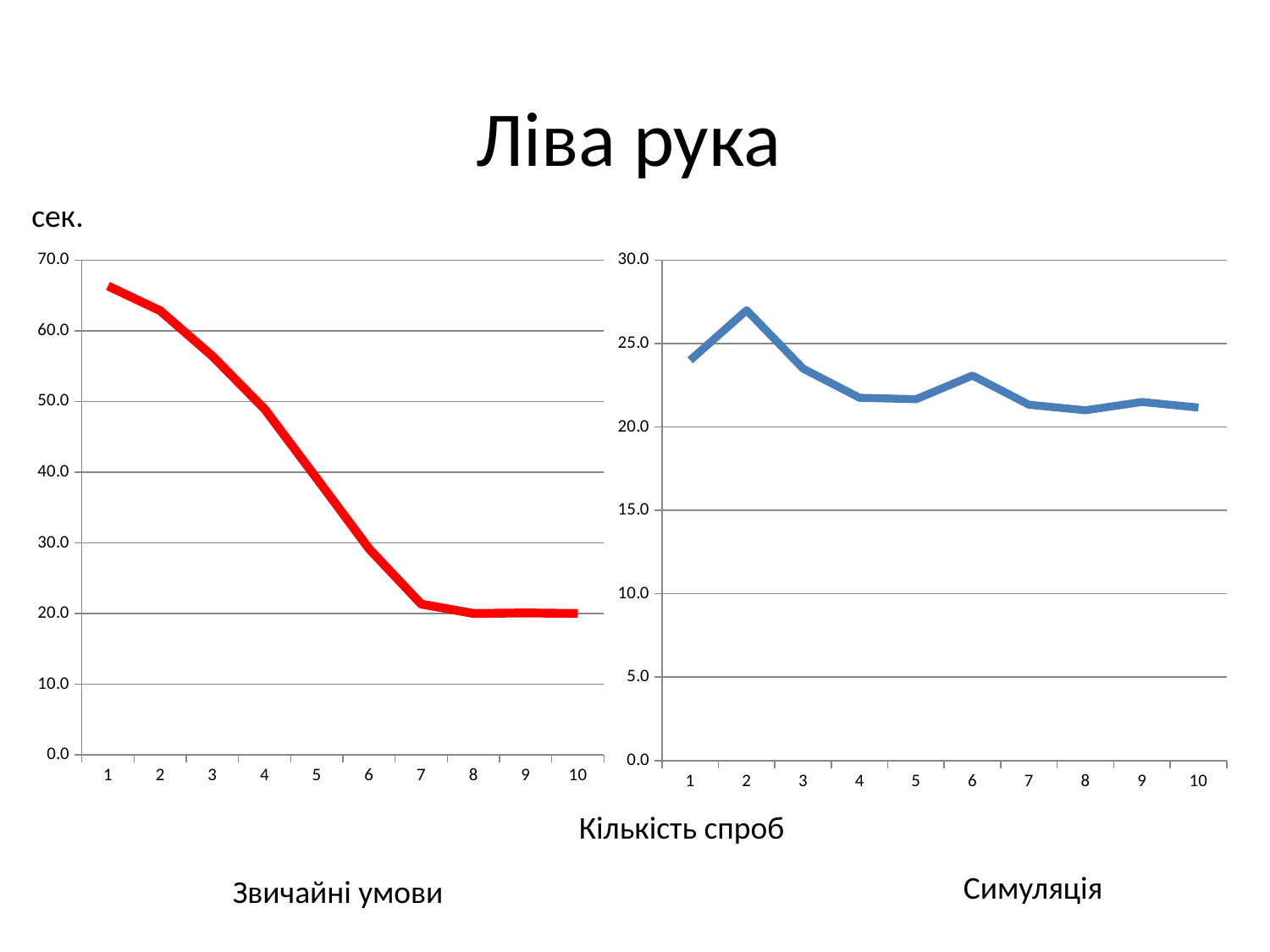
What kind of chart is the left chart (Звичайні умови)? Line chart In the left chart (Звичайні умови), is the value for trial 3 greater or less than 50? greater In the left chart (Звичайні умови), is the value for trial 1 greater or less than 60? greater In the left chart (Звичайні умови), do the values generally rise or fall as the trial number increases? Fall In the right chart (Симуляція), is the value for trial 2 greater or less than 25? greater How many trials (points) are plotted on the x axis of the right chart (Симуляція)? 10 In the right chart (Симуляція), at which trial number is the value highest? 2 In the left chart (Звичайні умови), at which trial number is the value highest? 1 What colour is the line in the right chart (Симуляція)? Blue What is the title of the slide above the two charts? Ліва рука In the left chart (Звичайні умови), which is larger: the value for trial 1 or the value for trial 7? Trial 1